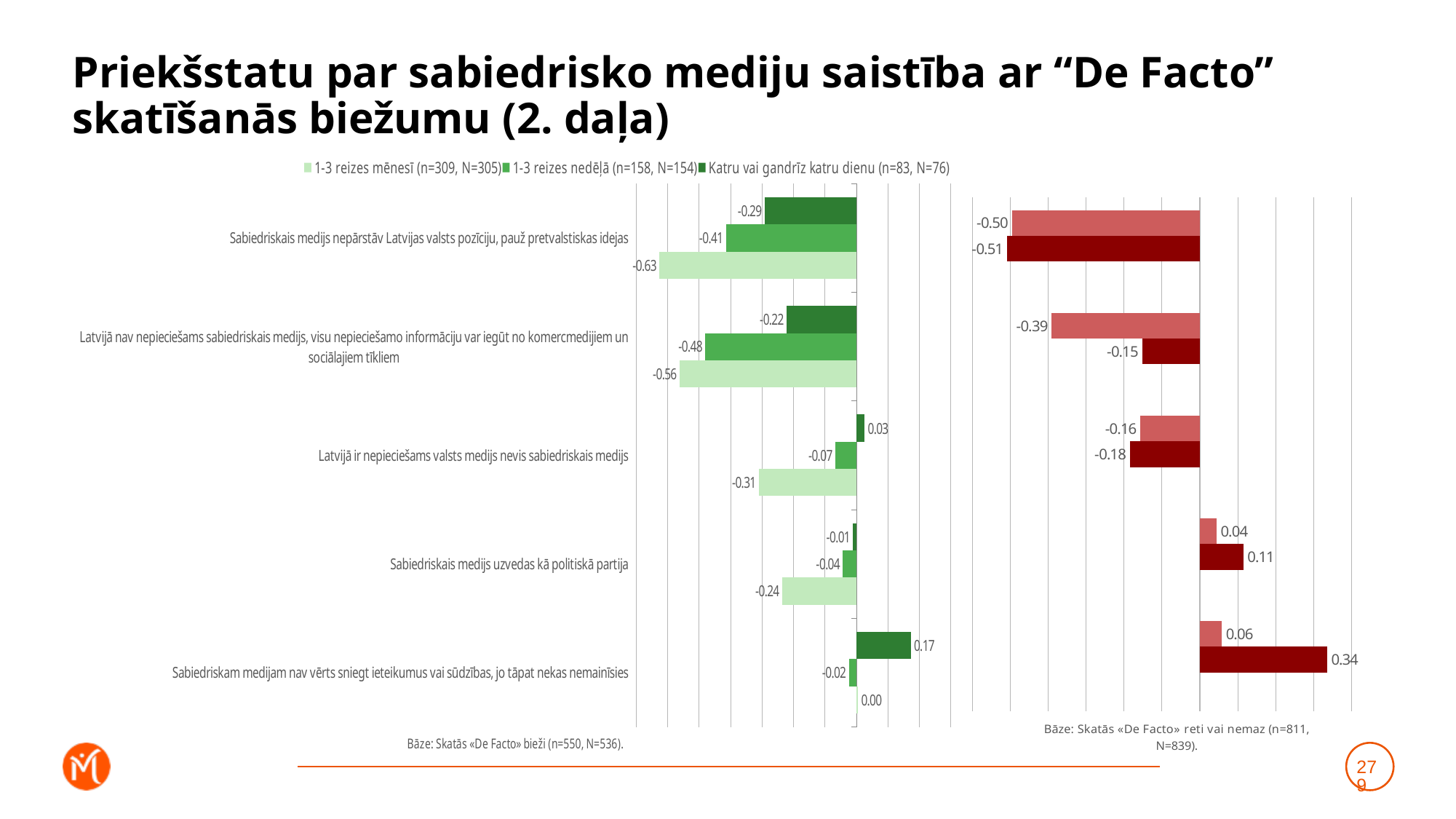
In the left (green) chart, which statement has the lowest value for the "1-3 reizes mēnesī" series? Sabiedriskais medijs nepārstāv Latvijas valsts pozīciju, pauž pretvalstiskas idejas How many statement categories are plotted in the left (green) chart? 5 In the left (green) chart, what is the value for "Katru vai gandrīz katru dienu" for the statement "Sabiedriskam medijam nav vērts sniegt ieteikumus vai sūdzības, jo tāpat nekas nemainīsies"? 0.17 How many series does the legend above the left (green) chart list? 3 In the left (green) chart, what is the value for "1-3 reizes nedēļā" for the statement "Latvijā nav nepieciešams sabiedriskais medijs, visu nepieciešamo informāciju var iegūt no komercmedijiem un sociālajiem tīkliem"? -0.48 What kind of chart is the left (green) chart on the slide? bar chart In the left (green) chart, what is the value for "1-3 reizes mēnesī" for the statement "Sabiedriskais medijs nepārstāv Latvijas valsts pozīciju, pauž pretvalstiskas idejas"? -0.63 In the left (green) chart, which statement has the highest value for the "Katru vai gandrīz katru dienu" series? Sabiedriskam medijam nav vērts sniegt ieteikumus vai sūdzības, jo tāpat nekas nemainīsies In the right (red) chart, what is the value of the darker red bar for "Sabiedriskam medijam nav vērts sniegt ieteikumus vai sūdzības, jo tāpat nekas nemainīsies"? 0.34 In the left (green) chart, what is the difference between the "1-3 reizes mēnesī" value (-0.31) and the "Katru vai gandrīz katru dienu" value (0.03) for "Latvijā ir nepieciešams valsts medijs nevis sabiedriskais medijs"? 0.34 In the right (red) chart, what is the value of the lighter red bar for "Latvijā nav nepieciešams sabiedriskais medijs, visu nepieciešamo informāciju var iegūt no komercmedijiem un sociālajiem tīkliem"? -0.39 In the left (green) chart, for "Sabiedriskais medijs uzvedas kā politiskā partija", which series has the larger value: "1-3 reizes mēnesī" or "Katru vai gandrīz katru dienu"? Katru vai gandrīz katru dienu